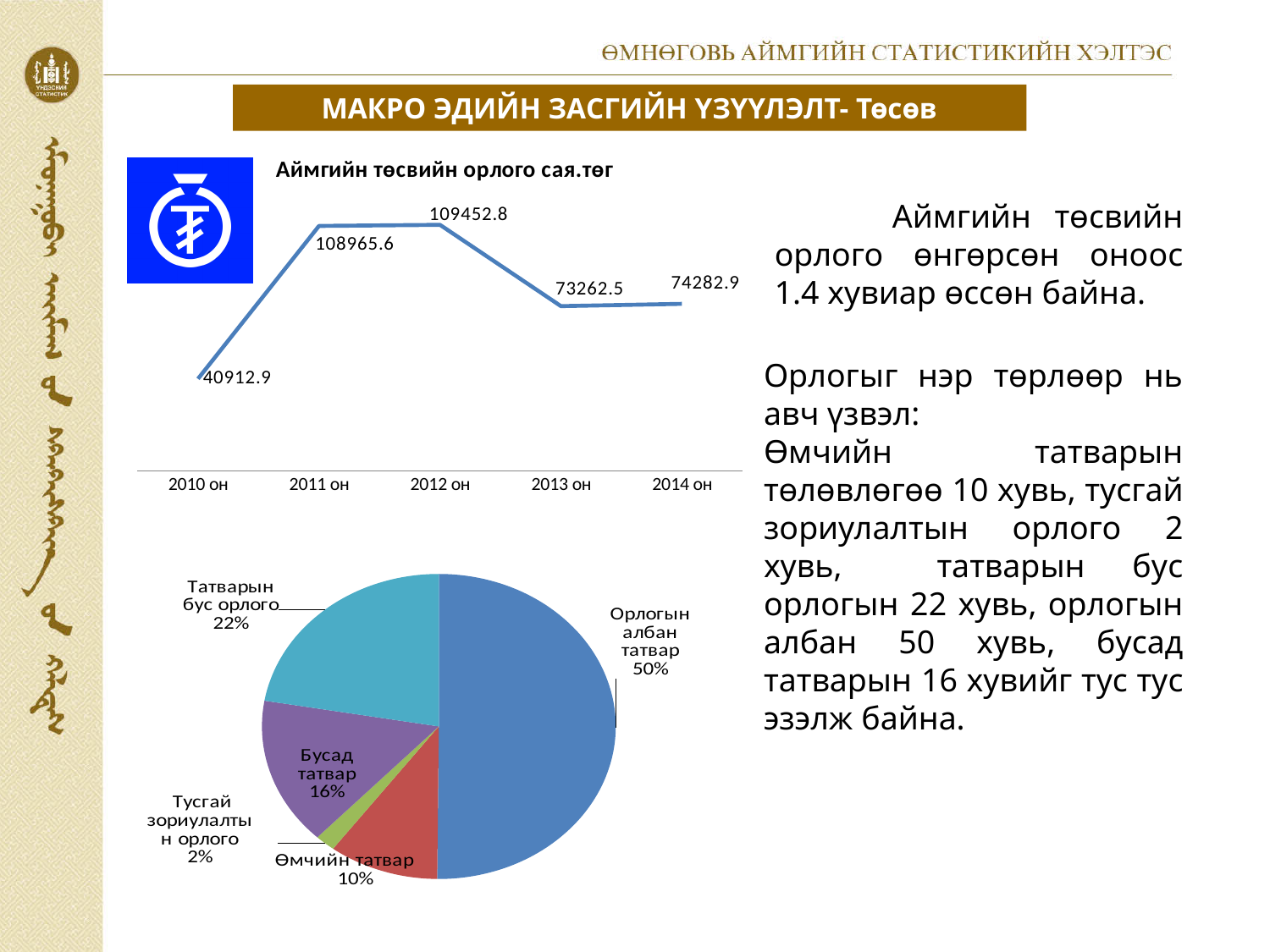
In the pie chart at the bottom of the slide, what share does 'Орлогын албан татвар' have? 50% How many years are plotted in the line chart 'Аймгийн төсвийн орлого сая.төг'? 5 How many slices does the pie chart at the bottom of the slide have? 5 In the line chart 'Аймгийн төсвийн орлого сая.төг', what is the difference between the values for 2014 он and 2013 он? 1020.4 In the line chart 'Аймгийн төсвийн орлого сая.төг', which is larger, the value for 2011 он or the value for 2013 он? 2011 он In the line chart 'Аймгийн төсвийн орлого сая.төг', which year has the highest value? 2012 он In the line chart 'Аймгийн төсвийн орлого сая.төг', does the value rise or fall from 2012 он to 2013 он? fall What type of chart is the chart titled 'Аймгийн төсвийн орлого сая.төг'? line chart In the line chart 'Аймгийн төсвийн орлого сая.төг', which year has the lowest value? 2010 он In the pie chart at the bottom of the slide, which slice is the smallest? Тусгай зориулалтын орлого In the line chart 'Аймгийн төсвийн орлого сая.төг', what is the value for 2012 он? 109452.8 In the line chart 'Аймгийн төсвийн орлого сая.төг', what is the value for 2010 он? 40912.9